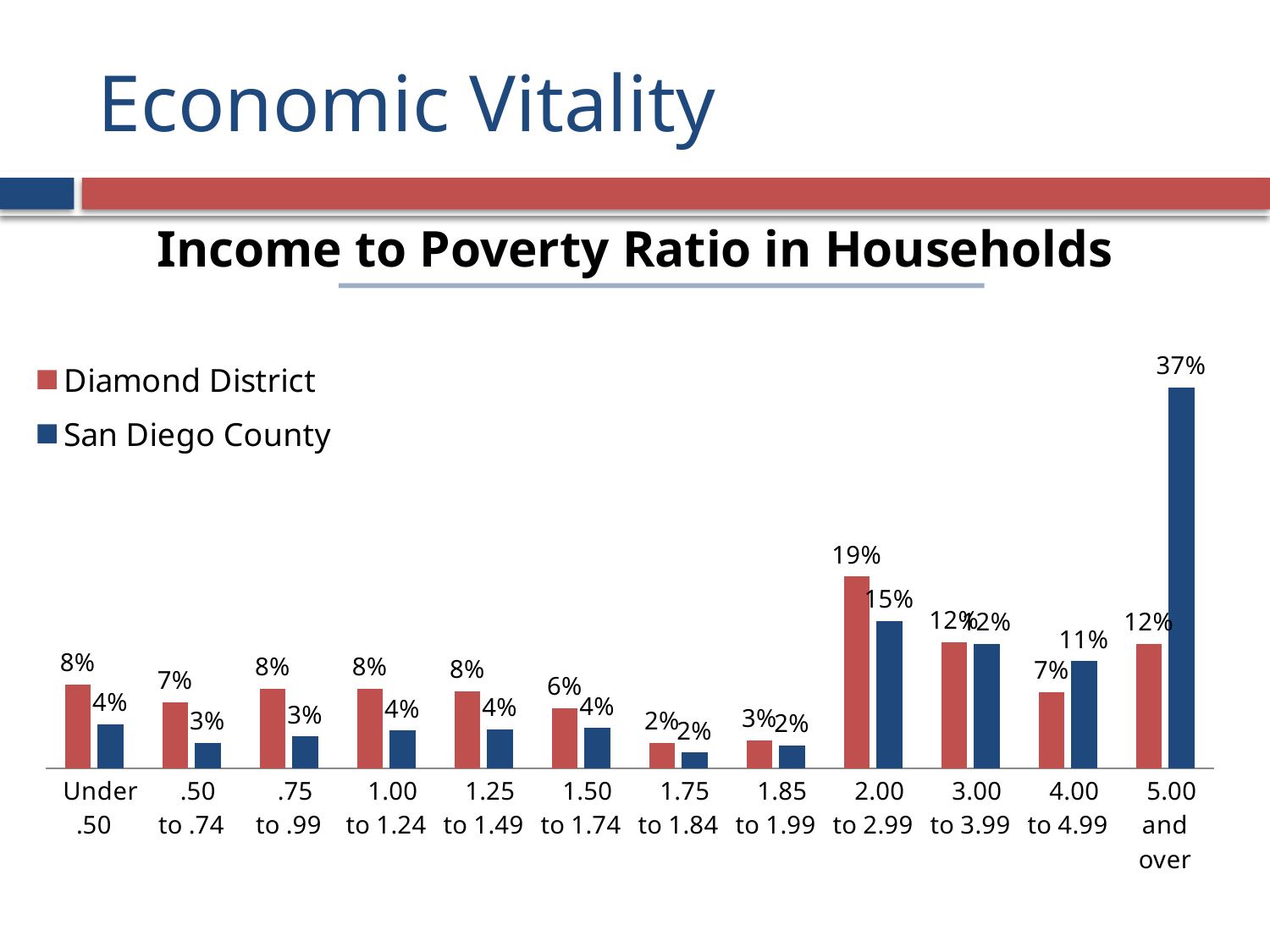
What is the San Diego County value for the 4.00 to 4.99 category? 11% Which category has the highest Diamond District value? 2.00 to 2.99 Which category has the highest San Diego County value? 5.00 and over What is the Diamond District value for the 2.00 to 2.99 income to poverty ratio category? 19% How many series does the legend list? 2 What is the difference between the Diamond District and San Diego County values for the 2.00 to 2.99 category? 4% What type of chart is shown on the slide? Bar chart What is the Diamond District value for the 1.50 to 1.74 category? 6% What is the difference between the San Diego County and Diamond District values for the 5.00 and over category? 25% What is the San Diego County value for the 5.00 and over category? 37% For the 4.00 to 4.99 category, which series has the larger value, Diamond District or San Diego County? San Diego County How many income to poverty ratio categories are shown on the x axis? 12